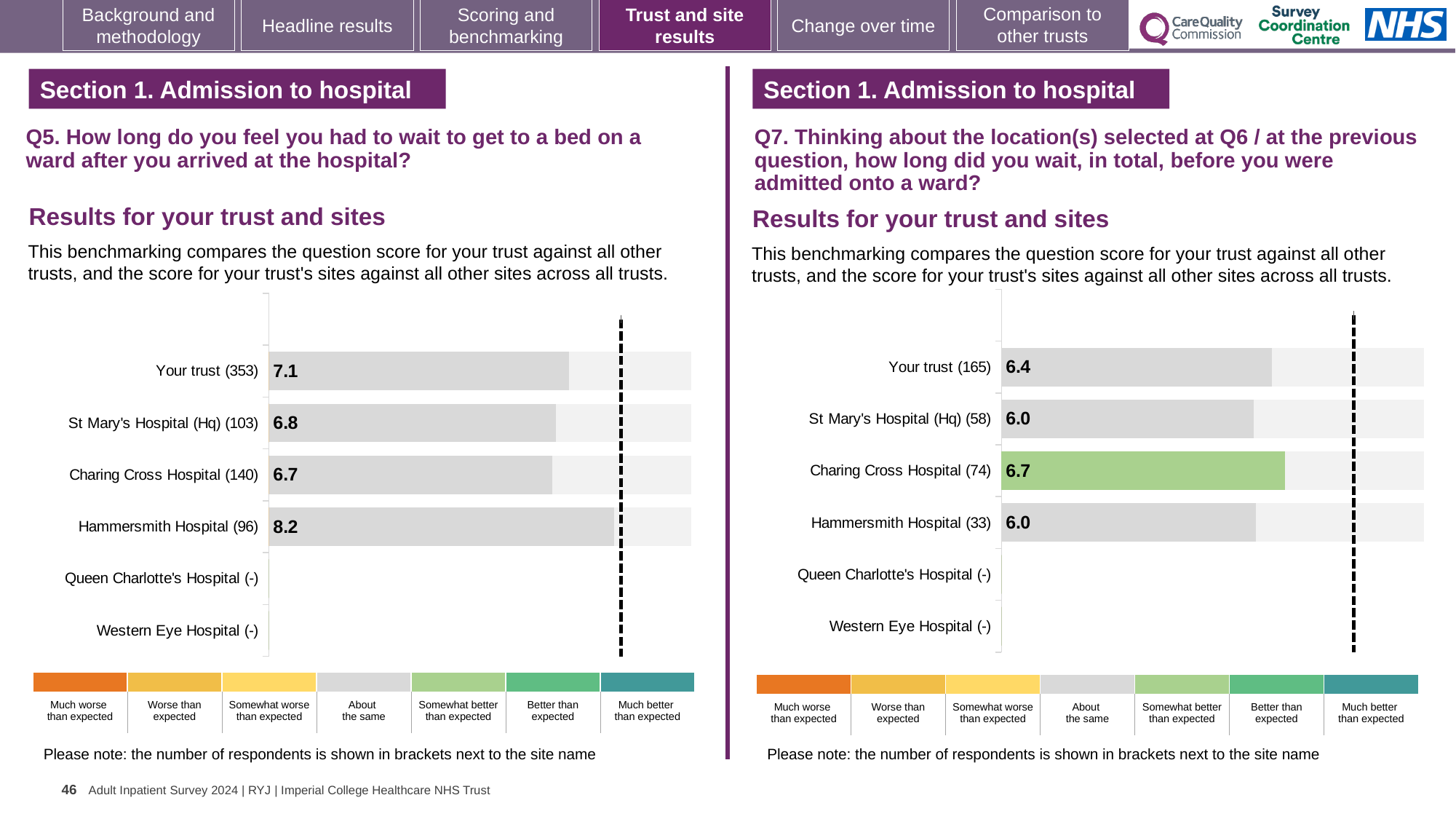
On the Q5 chart (left), which site has the lowest score among those with a plotted value? Charing Cross Hospital On the Q5 chart (left), how many sites or trust rows have a plotted score bar? 4 On the Q7 chart (right), which site has the highest score? Charing Cross Hospital On the Q5 chart (left), what is the score for Your trust? 7.1 On the Q7 chart (right), which has the larger score: Your trust or St Mary's Hospital (Hq)? Your trust On the Q7 chart (right), what is the difference between the scores for Charing Cross Hospital and Your trust? 0.3 What type of chart is used on the Q7 chart (right)? Bar chart On the Q5 chart (left), what is the difference between the scores for Hammersmith Hospital and St Mary's Hospital (Hq)? 1.4 On the Q7 chart (right), what is the score for Your trust? 6.4 On the Q7 chart (right), what is the score for Charing Cross Hospital? 6.7 On the Q5 chart (left), what is the score for Hammersmith Hospital? 8.2 On the Q5 chart (left), which site has the highest score? Hammersmith Hospital